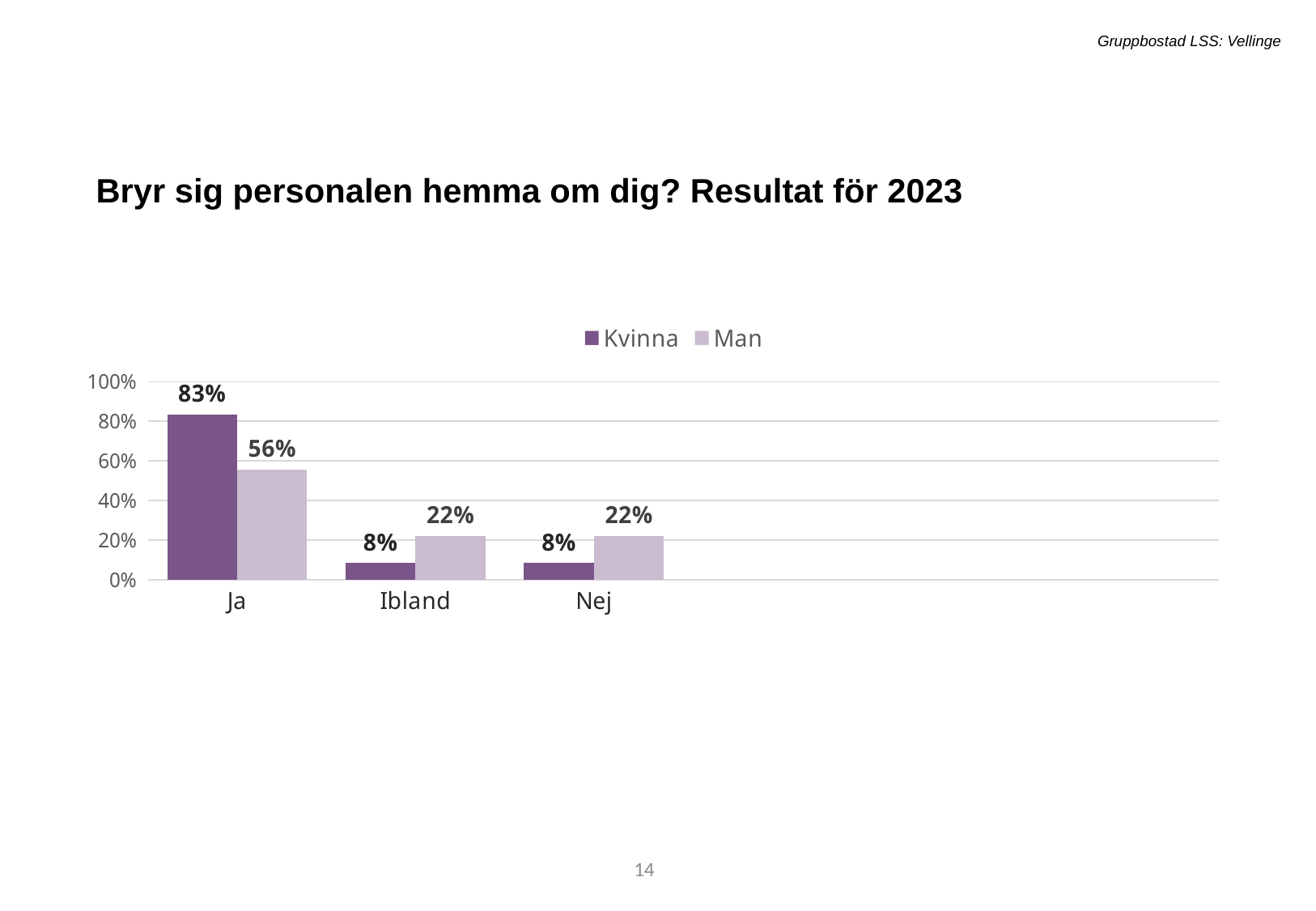
What kind of chart is shown on the slide? Bar chart What is the value for Man in the Ibland category? 22% What is the title of the chart on the slide? Bryr sig personalen hemma om dig? Resultat för 2023 How many categories are shown on the x axis? 3 In the Ibland category, which series has the larger value, Kvinna or Man? Man What is the value for Kvinna in the Ja category? 83% What is the value for Man in the Ja category? 56% Which category has the lowest value for Man? Ibland and Nej (tied at 22%) Which category has the highest value for Kvinna? Ja What is the value for Kvinna in the Nej category? 8% How many series does the legend list? 2 What is the difference between the Kvinna and Man values in the Ja category? 27%